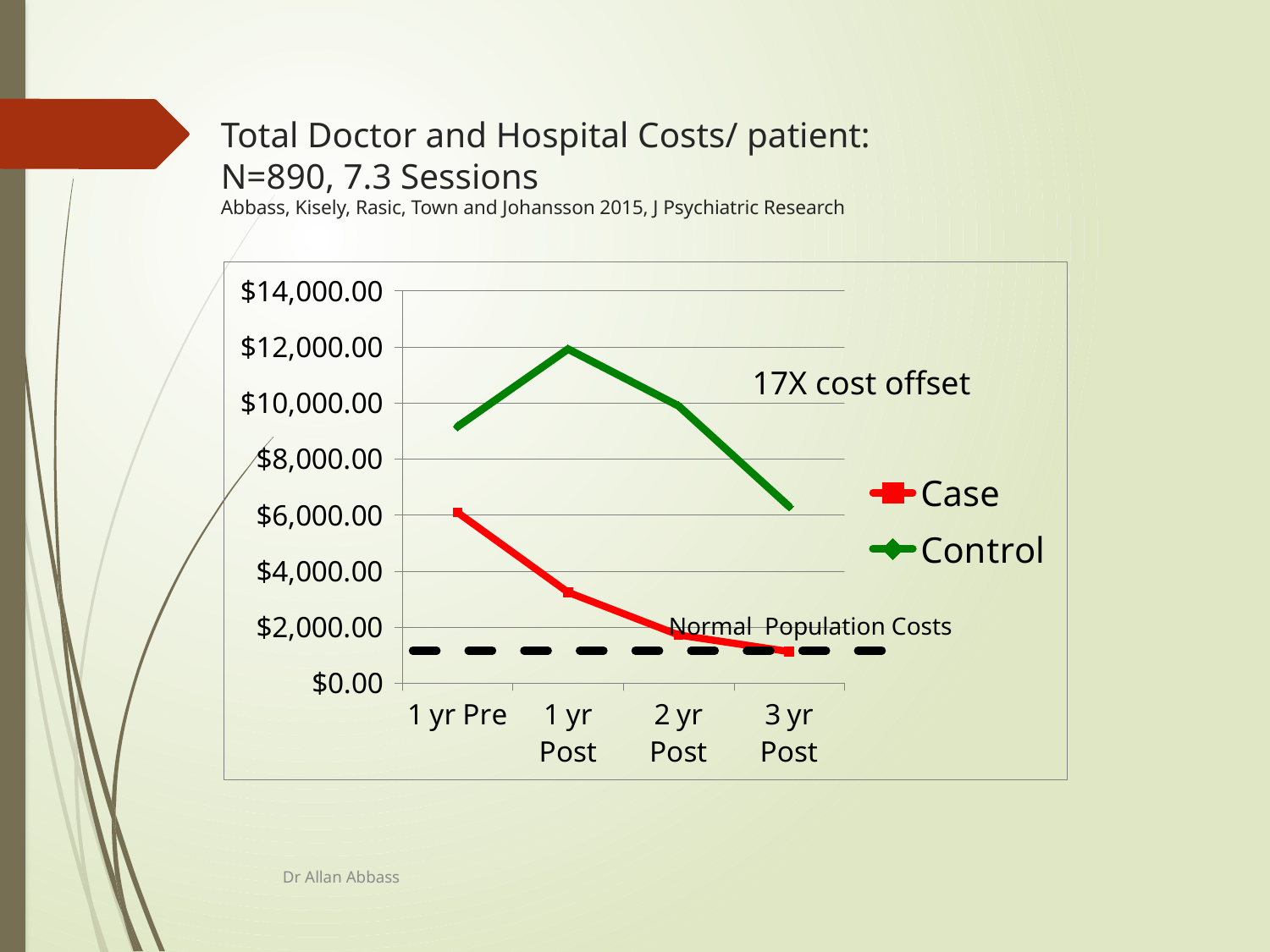
Is the Control value at 1 yr Post greater or less than $10,000.00? greater At 1 yr Post, which series has the larger value, Case or Control? Control Is the Control value at 3 yr Post greater or less than $8,000.00? less At which time point is the Case series lowest? 3 yr Post What label is given to the dashed horizontal line on the chart? Normal Population Costs How many series does the legend list? 2 What kind of chart is shown on the slide? line chart Is the Case value at 3 yr Post greater or less than $2,000.00? less Does the Case series rise or fall from 1 yr Pre to 3 yr Post? fall At which time point is the Case series highest? 1 yr Pre At which time point is the Control series highest? 1 yr Post How many time points are shown on the x axis? 4